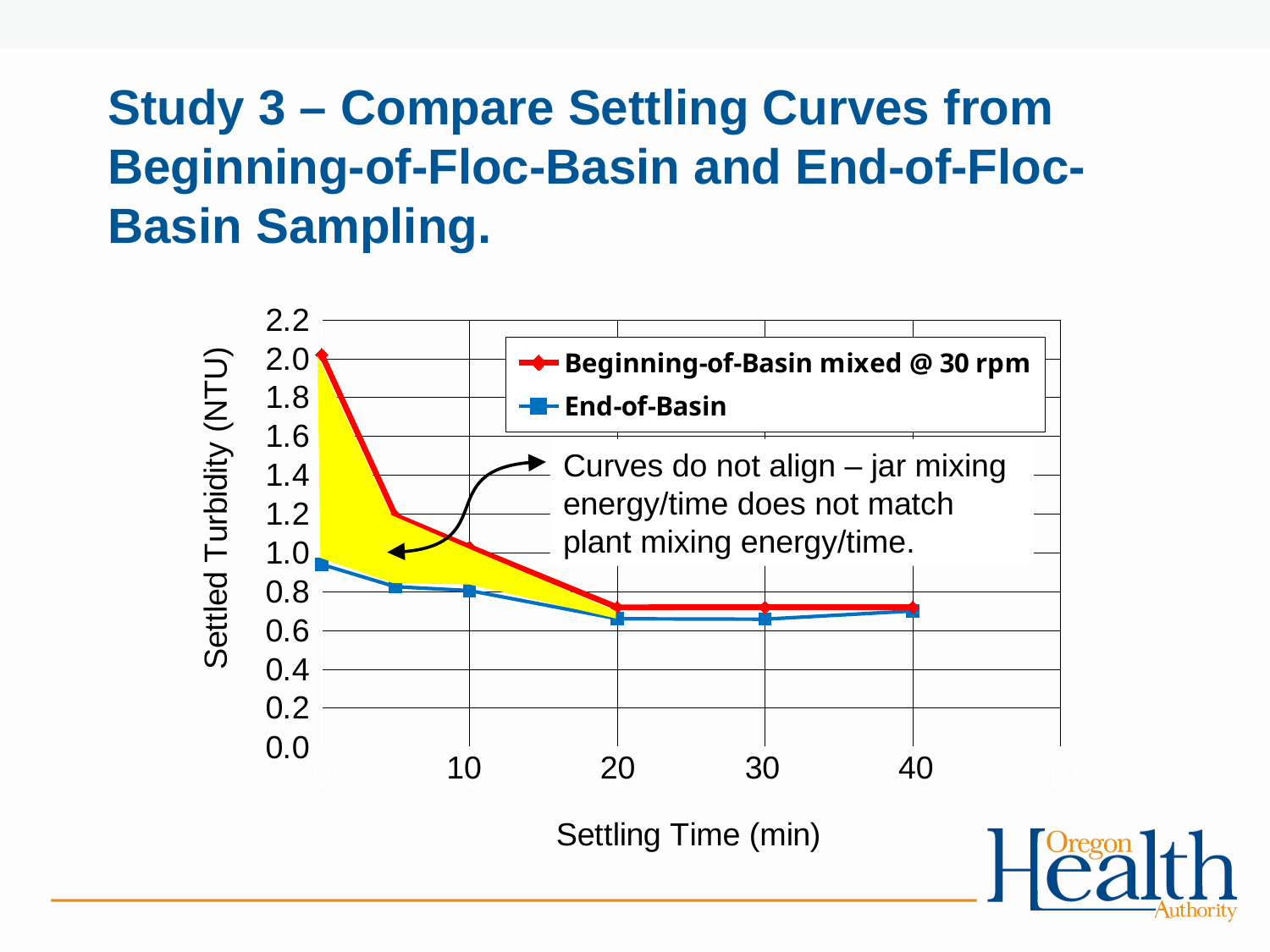
Is the End-of-Basin value at 0 min settling time greater or less than 1.2? less How many series does the legend list? 2 Which series has the higher settled turbidity at 10 min settling time? Beginning-of-Basin mixed @ 30 rpm What is the label of the y axis? Settled Turbidity (NTU) Which series has the higher settled turbidity at 0 min settling time? Beginning-of-Basin mixed @ 30 rpm Is the Beginning-of-Basin mixed @ 30 rpm value at 0 min settling time greater or less than 1.8? greater Does the Beginning-of-Basin mixed @ 30 rpm curve rise or fall as settling time increases from 0 to 20 min? fall At which settling time does the Beginning-of-Basin mixed @ 30 rpm series reach its highest settled turbidity? 0 min What kind of chart is shown on the slide? line chart Is the End-of-Basin value at 30 min settling time greater or less than 0.4? greater Which series is drawn in red? Beginning-of-Basin mixed @ 30 rpm